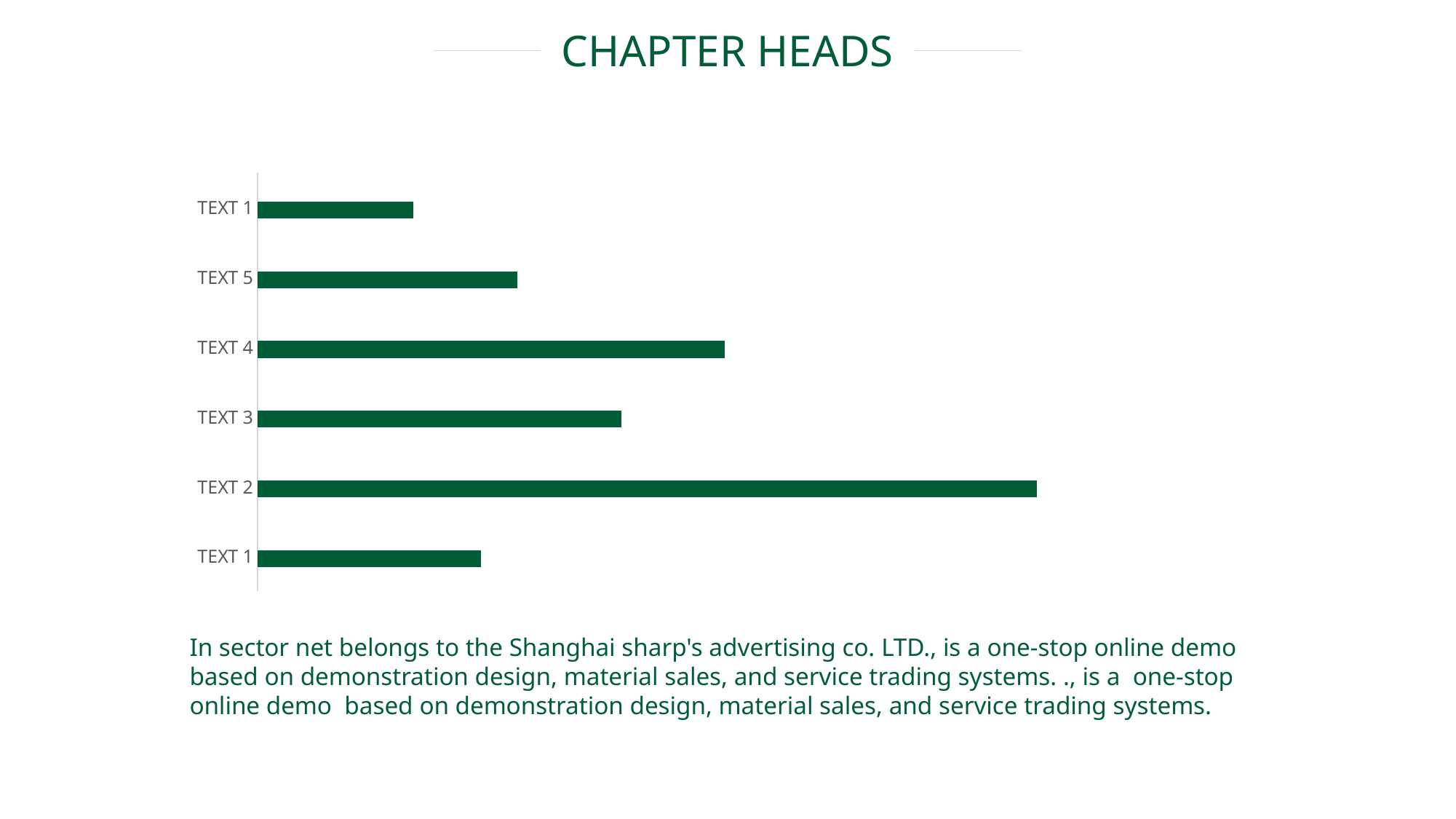
Which is larger, the value for TEXT 5 or the value for TEXT 3? TEXT 3 Which bar is the shortest in the chart? the top TEXT 1 bar What kind of chart is shown on the slide? bar chart Which is larger, the value for TEXT 4 or the value for TEXT 3? TEXT 4 Which category label appears twice on the chart's axis? TEXT 1 What is the title shown above the chart? CHAPTER HEADS Which is larger, the value for TEXT 5 or the value for TEXT 4? TEXT 4 How many bars does the chart show? 6 Which category has the longest bar? TEXT 2